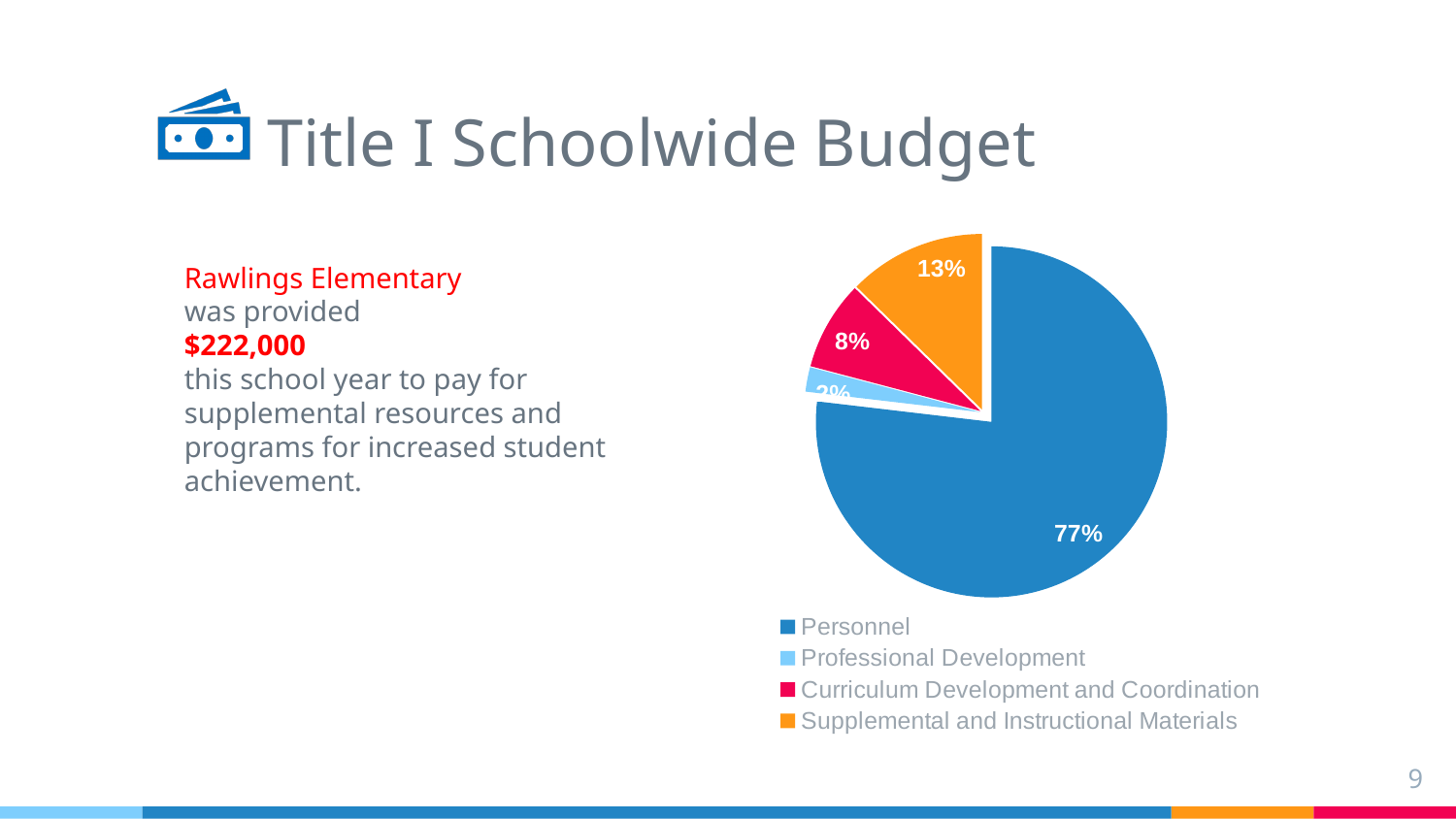
How many percentage points larger is the Personnel share than the Supplemental and Instructional Materials share? 64 percentage points How many categories are shown in the pie chart? 4 How many entries does the legend list? 4 What share of the budget is for Curriculum Development and Coordination? 8% What share of the budget is for Supplemental and Instructional Materials? 13% What share of the Title I Schoolwide Budget goes to Personnel? 77% Which category has the largest slice of the pie? Personnel What is the difference in percentage points between the Supplemental and Instructional Materials share and the Curriculum Development and Coordination share? 5 percentage points Which category has the smallest slice of the pie? Professional Development Which is larger: the share for Curriculum Development and Coordination or the share for Supplemental and Instructional Materials? Supplemental and Instructional Materials What kind of chart is shown on the slide? Pie chart What colour is the Personnel slice? Blue